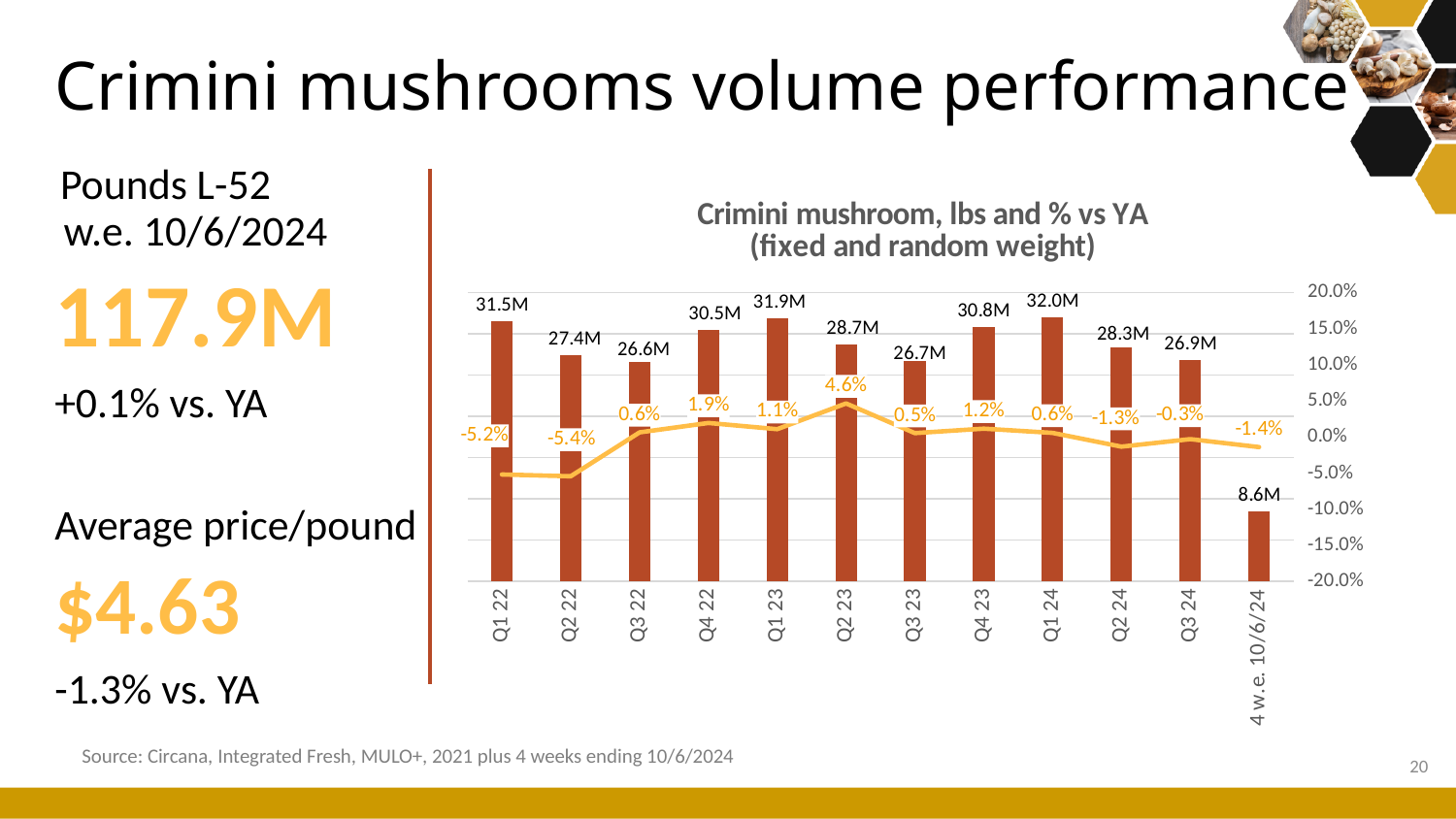
What is the difference in pounds between Q1 23 and Q3 23? 5.2M What is the % vs YA value for Q2 23? 4.6% What is the title of the chart? Crimini mushroom, lbs and % vs YA (fixed and random weight) Which quarter has the highest pounds value? Q1 24 What is the % vs YA value for Q3 24? -0.3% What is the pounds value for Q1 24? 32.0M Which is larger, the pounds value for Q4 22 or Q4 23? Q4 23 Which period has the lowest % vs YA value? Q2 22 What kind of chart is this? Bar chart with a line What is the difference in % vs YA between Q2 23 and Q3 23? 4.1% What is the pounds value for the 4 w.e. 10/6/24 period? 8.6M How many periods are shown on the x axis? 12